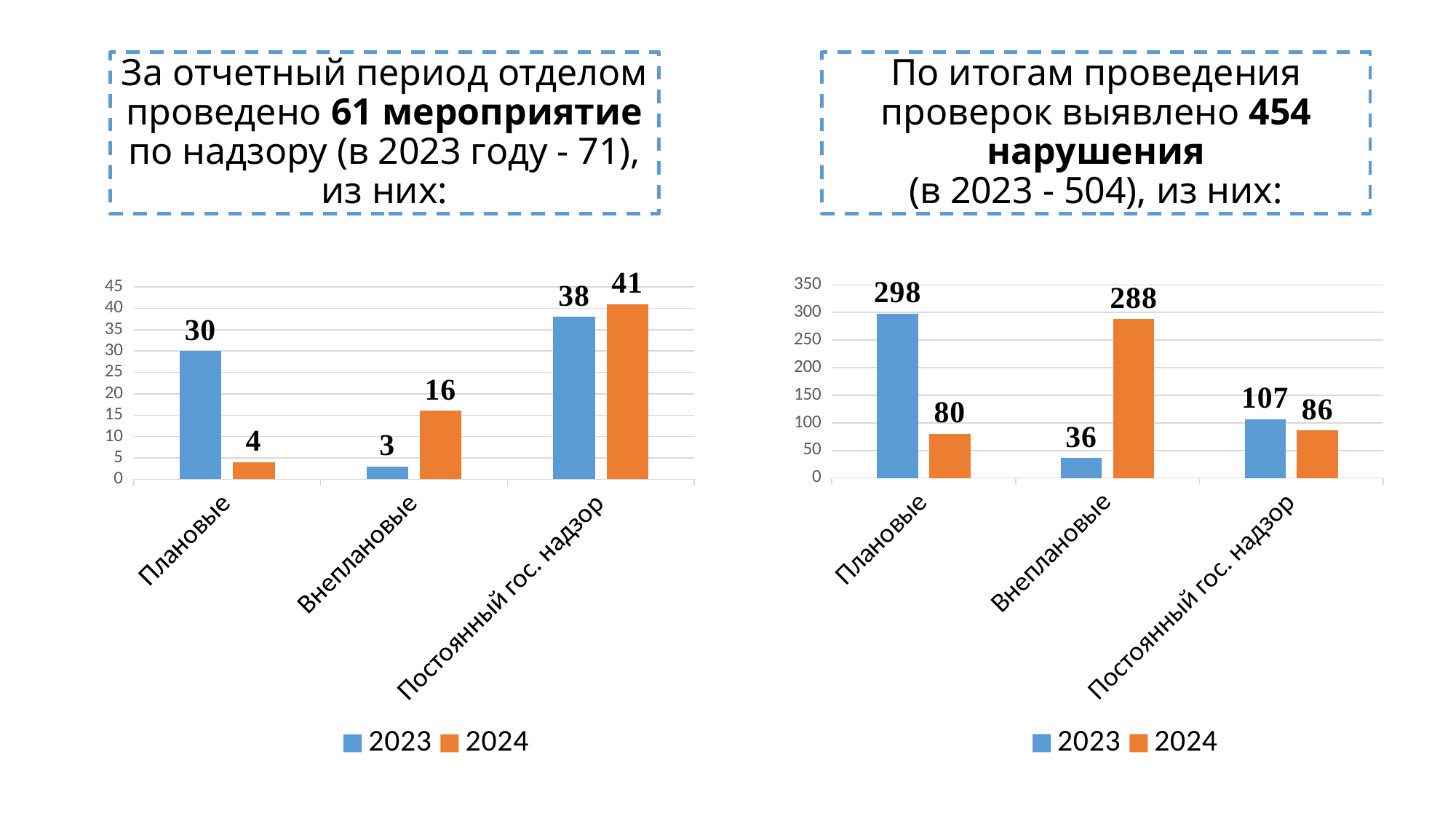
In the left chart (supervision activities), what is the 2023 value for Плановые? 30 In the right chart (violations), what is the difference between the 2024 and 2023 values for Внеплановые? 252 In the right chart (violations), which is larger for Плановые: the 2023 value or the 2024 value? 2023 In the left chart (supervision activities), how many series does the legend list? 2 In the left chart (supervision activities), which category has the lowest 2023 value? Внеплановые In the right chart (violations), what is the 2023 value for Плановые? 298 In the right chart (violations), which category has the lowest 2023 value? Внеплановые In the left chart (supervision activities), which category has the highest 2024 value? Постоянный гос. надзор In the left chart (supervision activities), what is the 2024 value for Внеплановые? 16 What type of chart is the right chart (violations)? Bar chart In the left chart (supervision activities), what is the difference between the 2024 and 2023 values for Постоянный гос. надзор? 3 In the right chart (violations), what is the 2024 value for Постоянный гос. надзор? 86